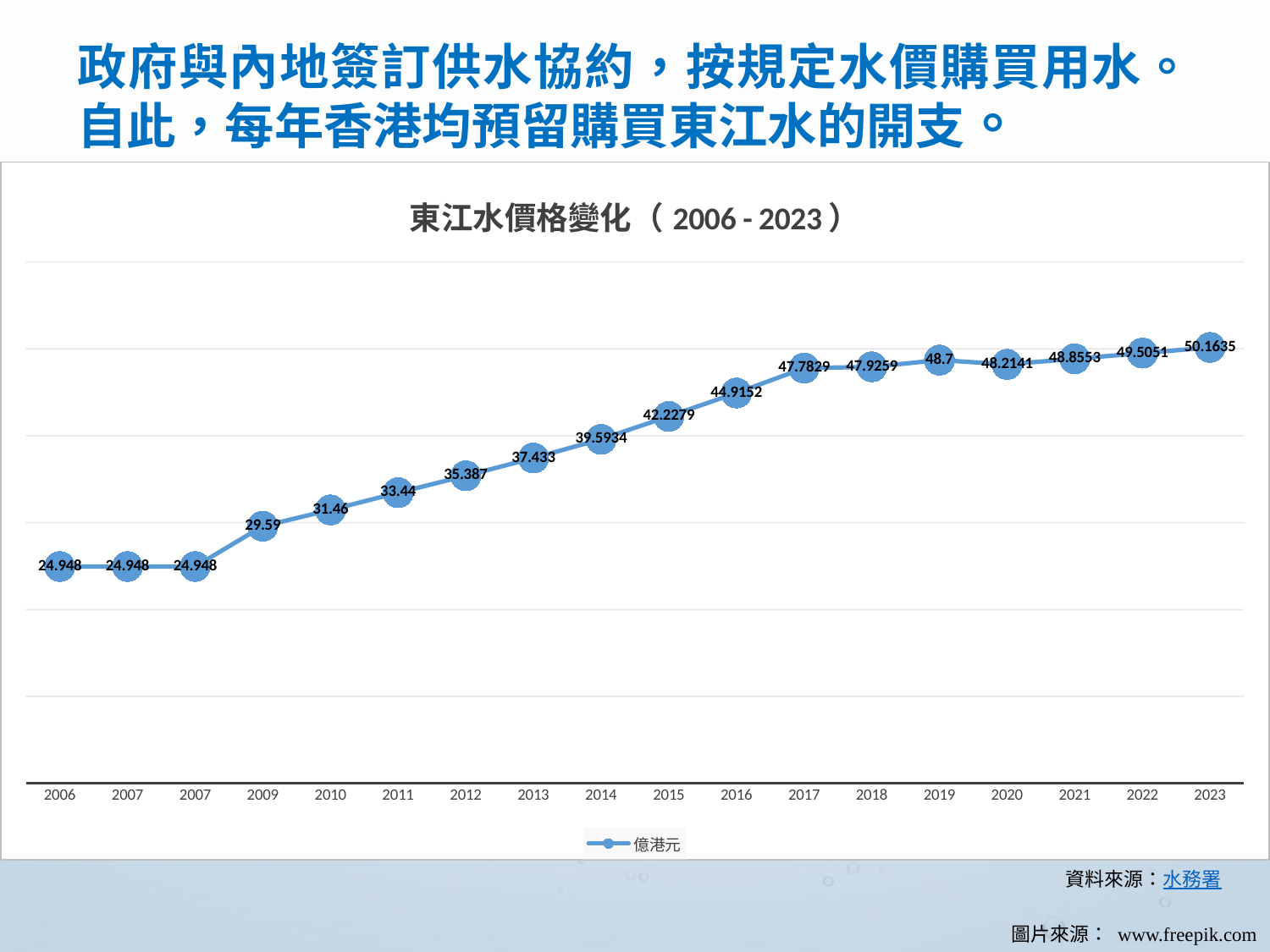
What is the difference between the values for 2009 and 2006? 4.642 What is the value for 2006 in the chart? 24.948 Which is larger, the value for 2019 or the value for 2020? 2019 How many data points are plotted in the chart? 18 Which year has the highest value in the chart? 2023 What is the value for 2023 in the 東江水價格變化 chart? 50.1635 What is the value for 2019 in the chart? 48.7 What is the difference between the values for 2023 and 2022? 0.6584 What type of chart is shown on the slide? line chart What is the value for 2014 in the chart? 39.5934 What is the legend entry shown below the chart? 億港元 Overall, do the values rise or fall from 2006 to 2023? rise